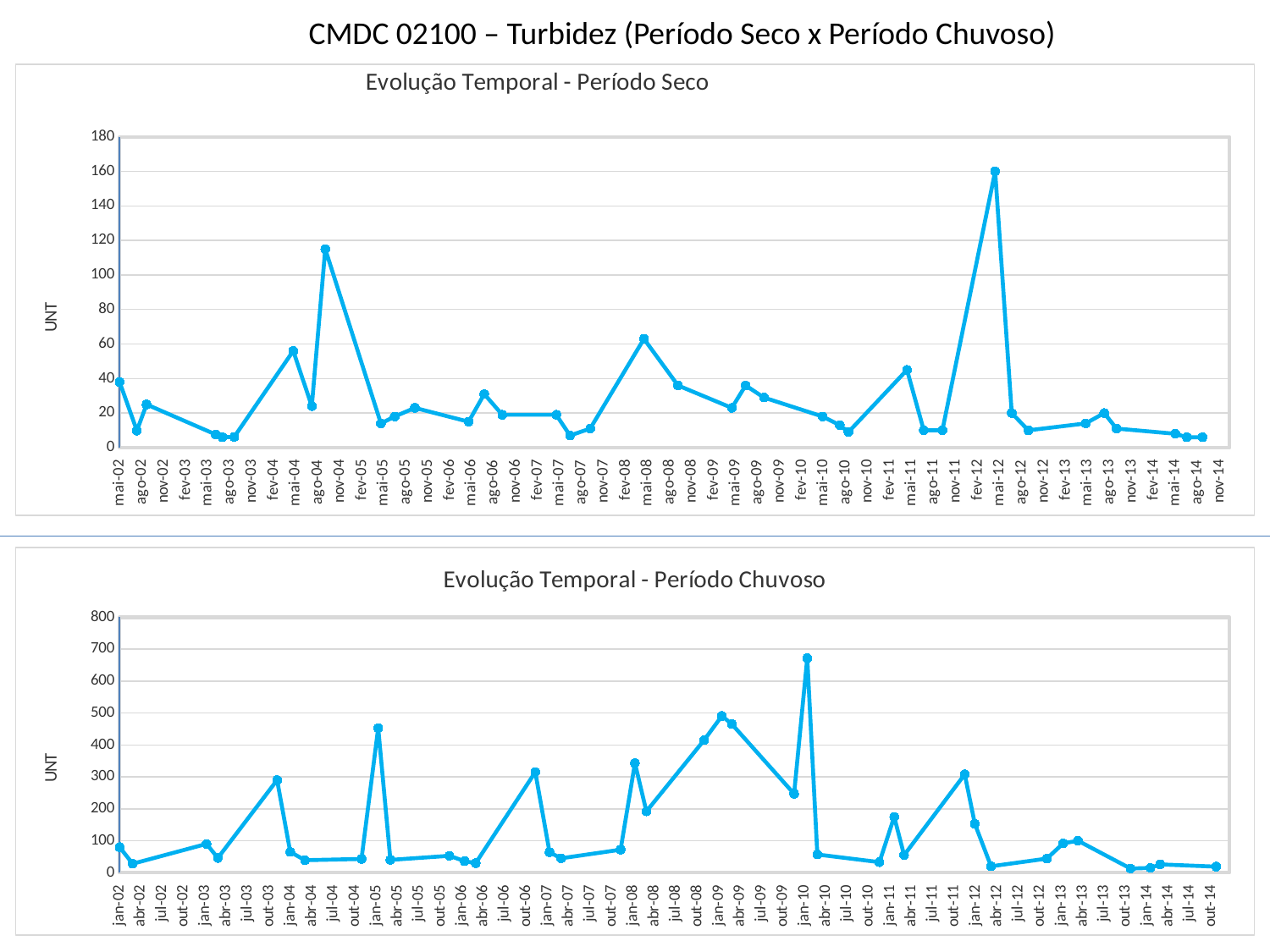
In the bottom chart 'Evolução Temporal - Período Chuvoso', is the value at jan-05 greater or less than 400? greater In the bottom chart 'Evolução Temporal - Período Chuvoso', which is larger: the value at jan-10 or the value at jan-05? jan-10 What is the maximum value shown on the vertical axis of the bottom chart 'Evolução Temporal - Período Chuvoso'? 800 In the top chart 'Evolução Temporal - Período Seco', which is larger: the value at mai-12 or the value at ago-04? mai-12 In the bottom chart 'Evolução Temporal - Período Chuvoso', is the value at jan-10 greater or less than 600? greater What kind of chart is the top chart, 'Evolução Temporal - Período Seco'? line chart In the bottom chart 'Evolução Temporal - Período Chuvoso', does the line rise or fall between jan-10 and abr-10? fall In the top chart 'Evolução Temporal - Período Seco', at which date does the line reach its highest value? mai-12 In the top chart 'Evolução Temporal - Período Seco', is the value at mai-12 greater or less than 140? greater What is the label on the vertical axis of the top chart 'Evolução Temporal - Período Seco'? UNT In the bottom chart 'Evolução Temporal - Período Chuvoso', at which date does the line reach its highest value? jan-10 What kind of chart is the bottom chart, 'Evolução Temporal - Período Chuvoso'? line chart